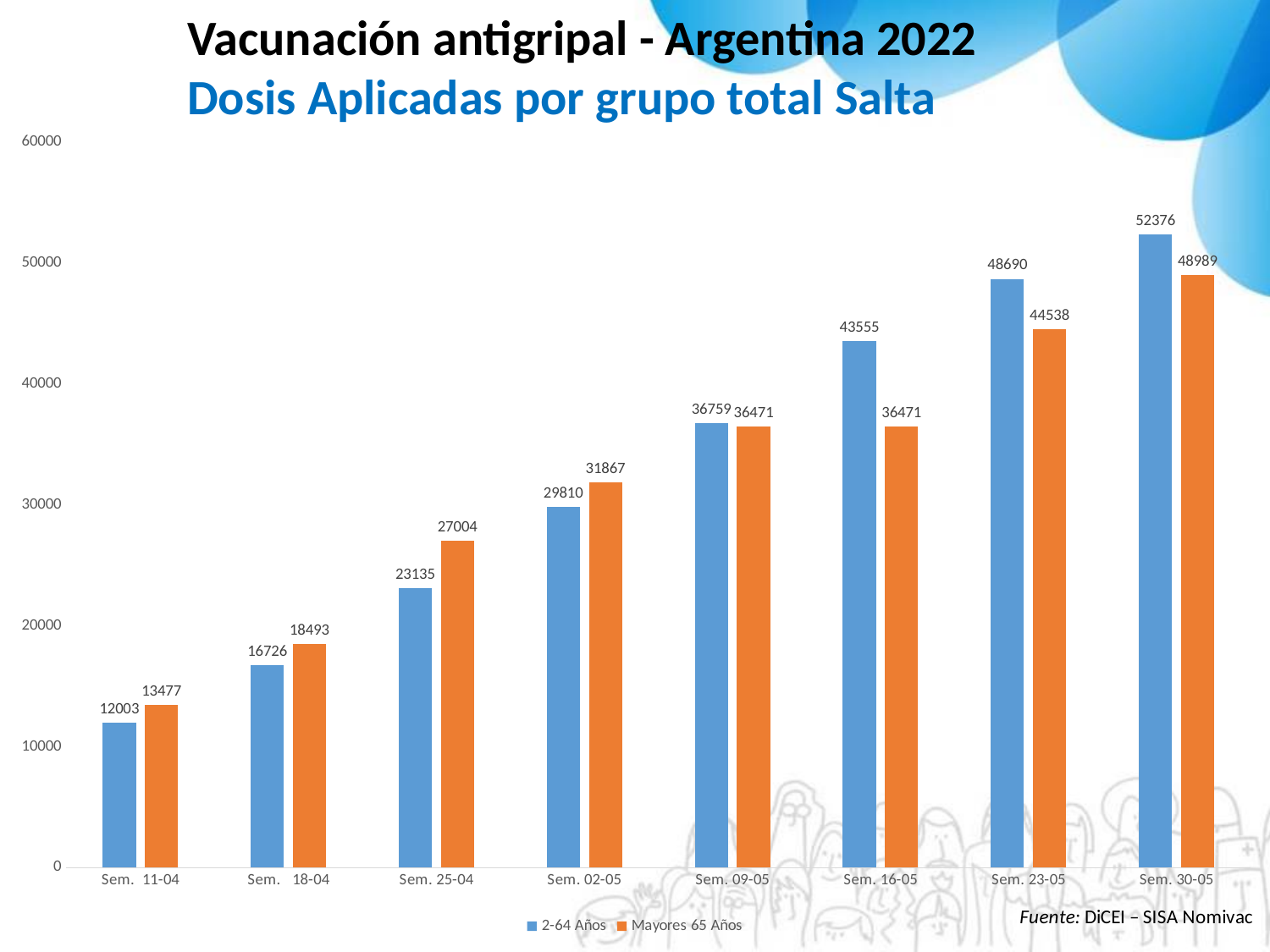
What is the value for Mayores 65 Años in Sem. 25-04? 27004 What type of chart is shown on the slide? bar chart How many series does the legend list? 2 How many weeks (categories) are shown on the x axis? 8 In which week is the value for Mayores 65 Años highest? Sem. 30-05 What is the value for 2-64 Años in Sem. 11-04? 12003 In Sem. 02-05, which series has the larger value, 2-64 Años or Mayores 65 Años? Mayores 65 Años In which week is the value for 2-64 Años lowest? Sem. 11-04 What is the value for 2-64 Años in Sem. 30-05? 52376 What is the title of the chart? Dosis Aplicadas por grupo total Salta Do the values for 2-64 Años rise or fall from Sem. 11-04 to Sem. 30-05? rise What is the difference between 2-64 Años and Mayores 65 Años in Sem. 16-05? 7084